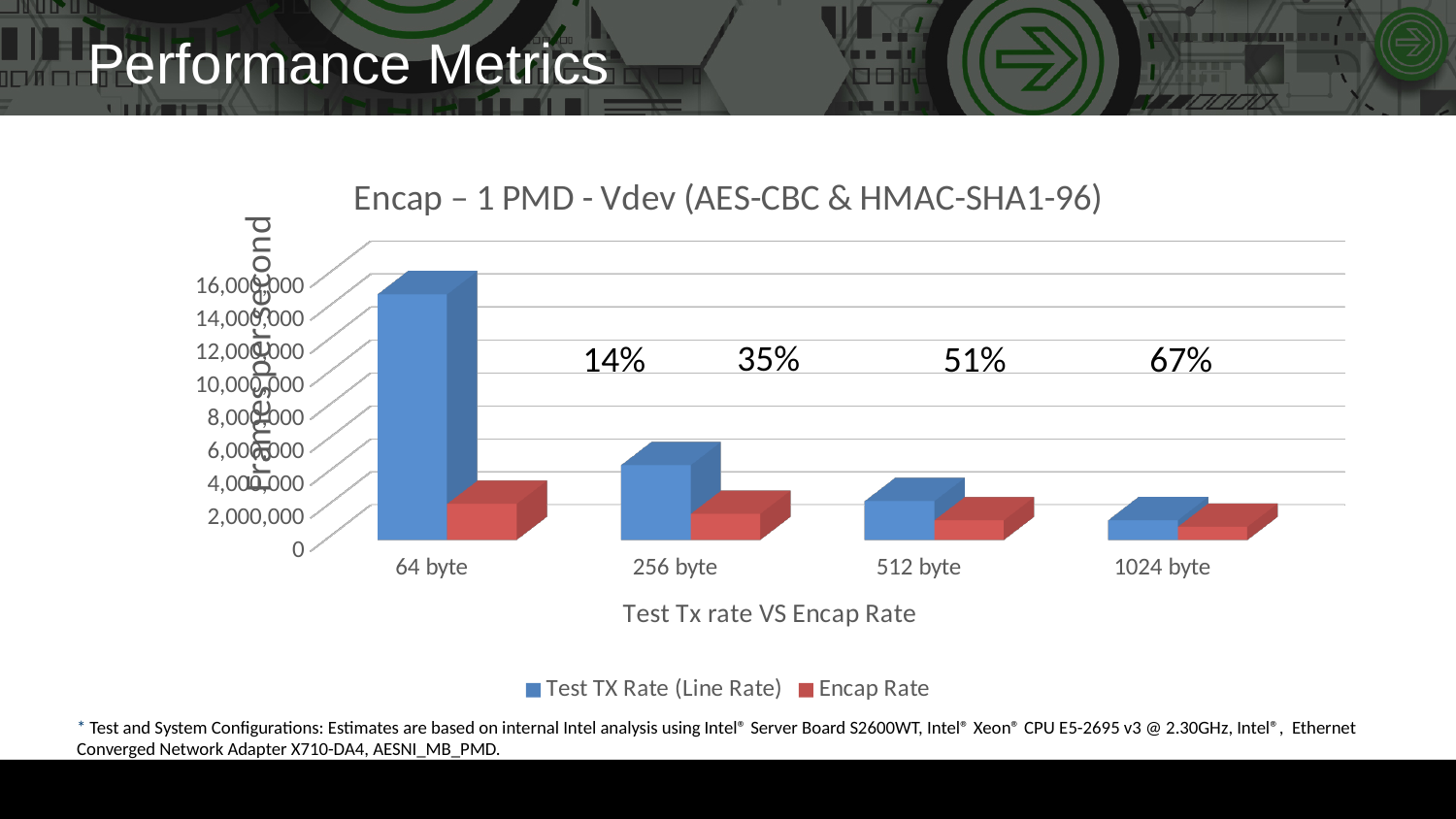
Which category has the highest Test TX Rate (Line Rate)? 64 byte Is the Test TX Rate (Line Rate) for 64 byte greater or less than 12,000,000? greater How many series does the legend list? 2 How many packet-size categories are shown on the x axis? 4 What kind of chart is shown on the slide? bar chart Which is larger at 64 byte: the Test TX Rate (Line Rate) or the Encap Rate? Test TX Rate (Line Rate) Is the Encap Rate for 64 byte greater or less than 4,000,000? less What percentage is printed above the 512 byte category? 51% Which category has the lowest Encap Rate? 1024 byte Is the Test TX Rate (Line Rate) for 256 byte greater or less than 8,000,000? less Does the Test TX Rate (Line Rate) rise or fall as packet size increases from 64 byte to 1024 byte? fall What is the title of the chart? Encap – 1 PMD - Vdev (AES-CBC & HMAC-SHA1-96)